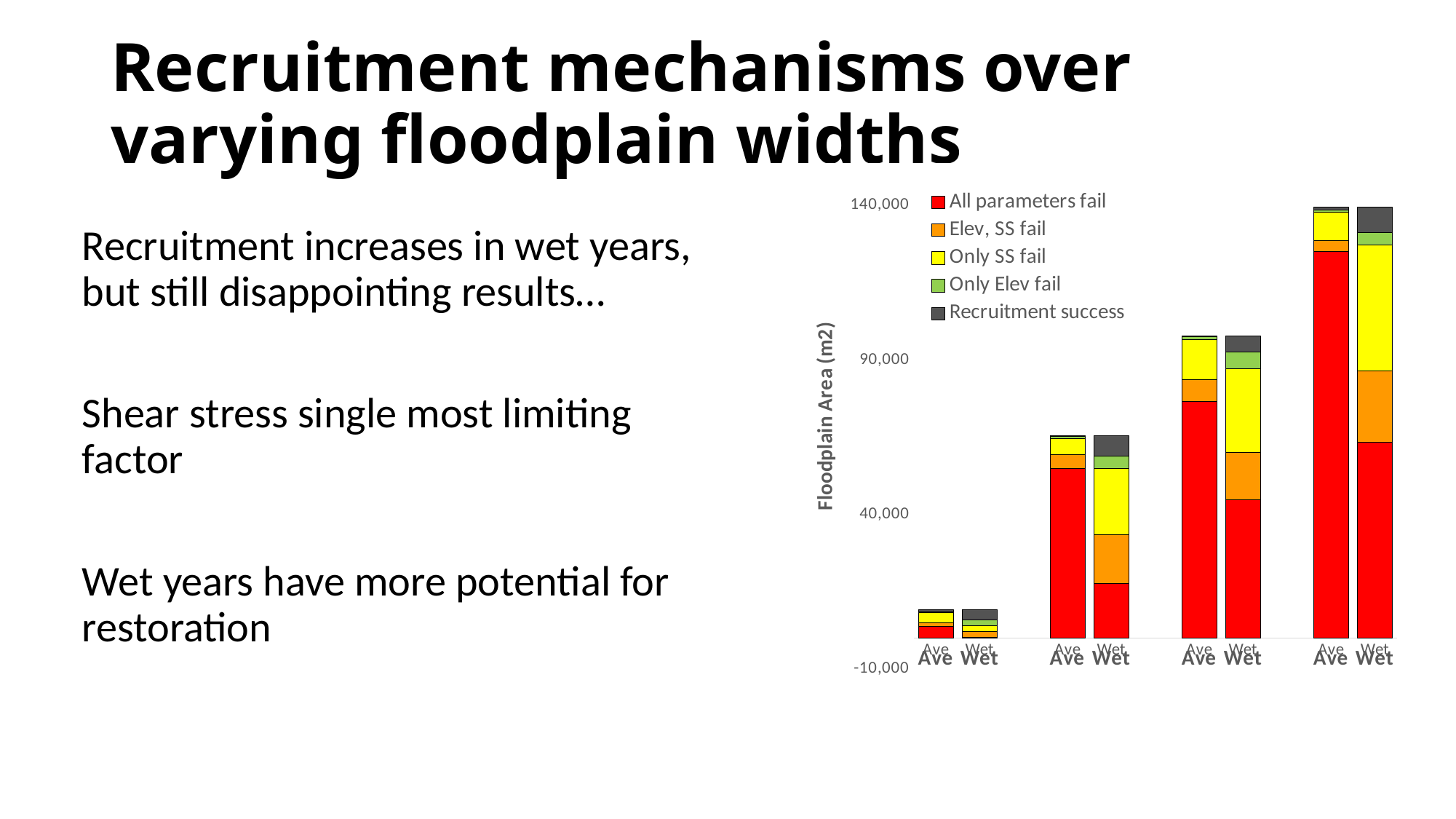
In the second group from the left, which bar has the larger 'All parameters fail' (red) segment, Ave or Wet? Ave What is the label of the vertical axis of the chart? Floodplain Area (m2) How many series does the chart legend list? 5 Is the 'All parameters fail' segment of the Wet bar in the second group from the left greater or less than 40,000? less Do the total bar heights generally rise or fall moving from the leftmost group to the rightmost group? rise Is the total of the Ave bar in the second group from the left greater or less than 40,000? greater How many bars are plotted in the chart? 8 Is the total of the Ave bar in the second group from the left greater or less than 90,000? less Which legend entry is shown in red? All parameters fail What kind of chart is shown on the slide? Stacked bar chart In the rightmost group, which bar has the larger 'Recruitment success' (dark grey) segment, Ave or Wet? Wet